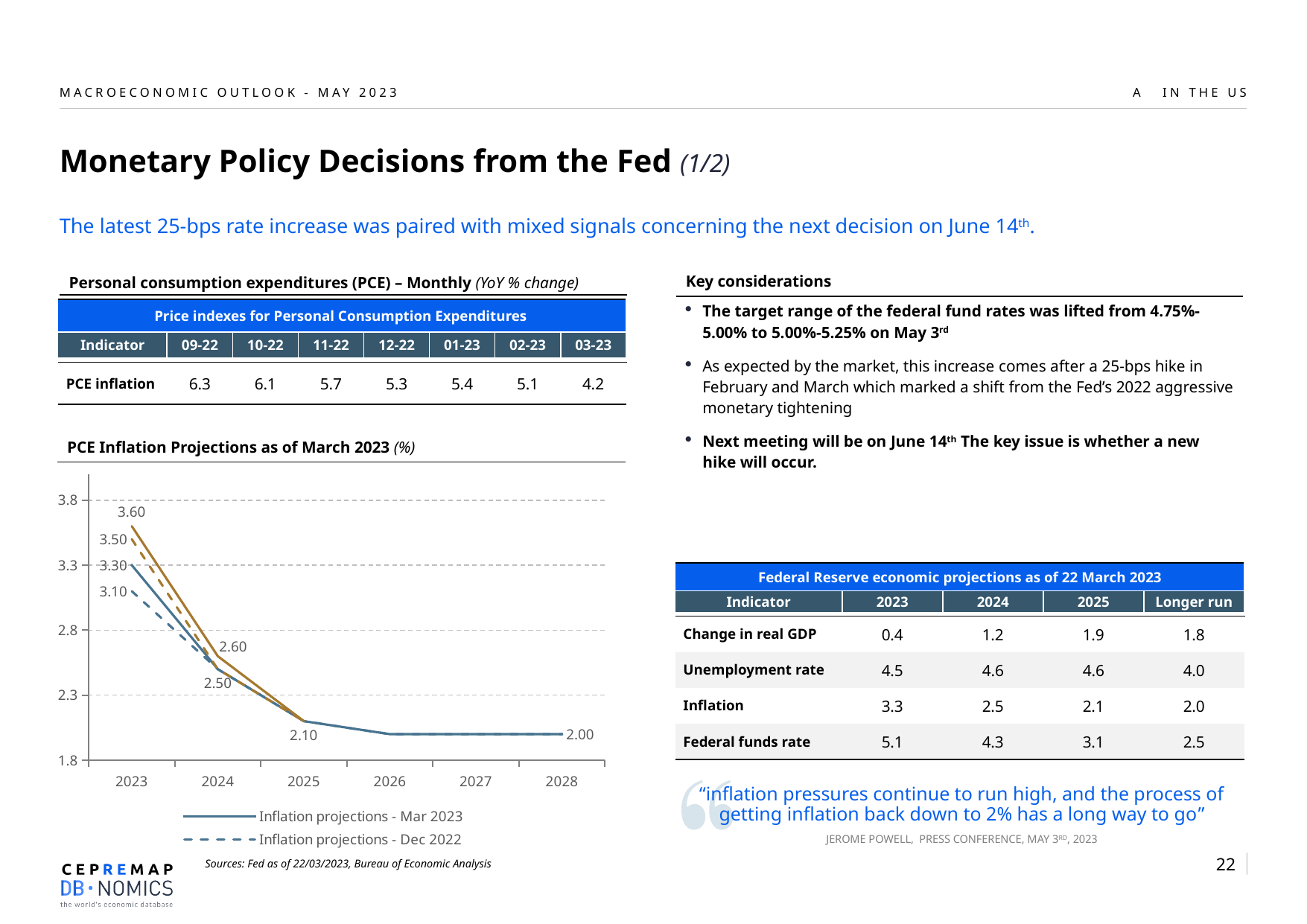
In the PCE Inflation Projections chart, what is the lowest value labelled for 2023? 3.10 How many years are shown on the x axis of the PCE Inflation Projections chart? 6 What kind of chart is the 'PCE Inflation Projections as of March 2023' chart? line chart In the PCE Inflation Projections chart, what is the difference between the highest (3.60) and lowest (3.10) values labelled for 2023? 0.50 In the PCE Inflation Projections chart, what value is labelled for 2025? 2.10 In the PCE Inflation Projections chart, do the projections rise or fall from 2023 to 2028? fall In the PCE Inflation Projections chart, what is the highest value labelled for 2023? 3.60 In the PCE Inflation Projections chart, which legend entry is drawn with a dashed line? Inflation projections - Dec 2022 In the PCE Inflation Projections chart, is the value for 2026 greater or less than 2.3? less In the PCE Inflation Projections chart, what is the difference between the two values labelled for 2024 (2.60 and 2.50)? 0.10 In the PCE Inflation Projections chart, what value is labelled for 2028? 2.00 How many entries does the legend of the PCE Inflation Projections chart list? 2